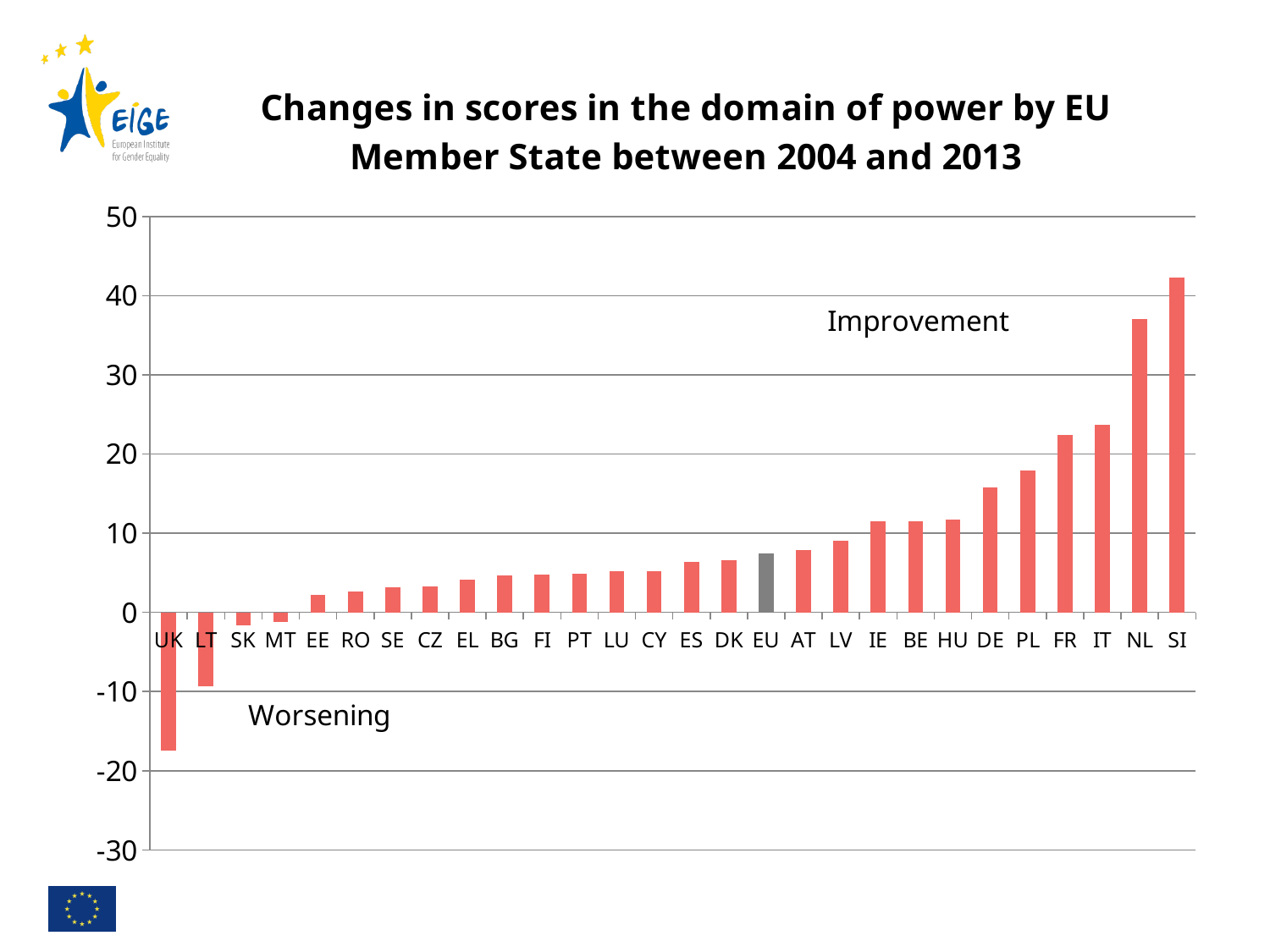
Is the value for NL greater or less than 40? less How many categories are shown on the x axis of the chart? 28 Is the value for EU greater or less than 10? less Which bar is coloured grey instead of red? EU Is the value for SI greater or less than 40? greater Which has the larger value, NL or SI? SI Which Member State has the highest change in score in the domain of power? SI Which Member State has the lowest change in score in the domain of power? UK What kind of chart is shown on the slide? Bar chart Do the values rise or fall moving from left to right along the x axis? rise